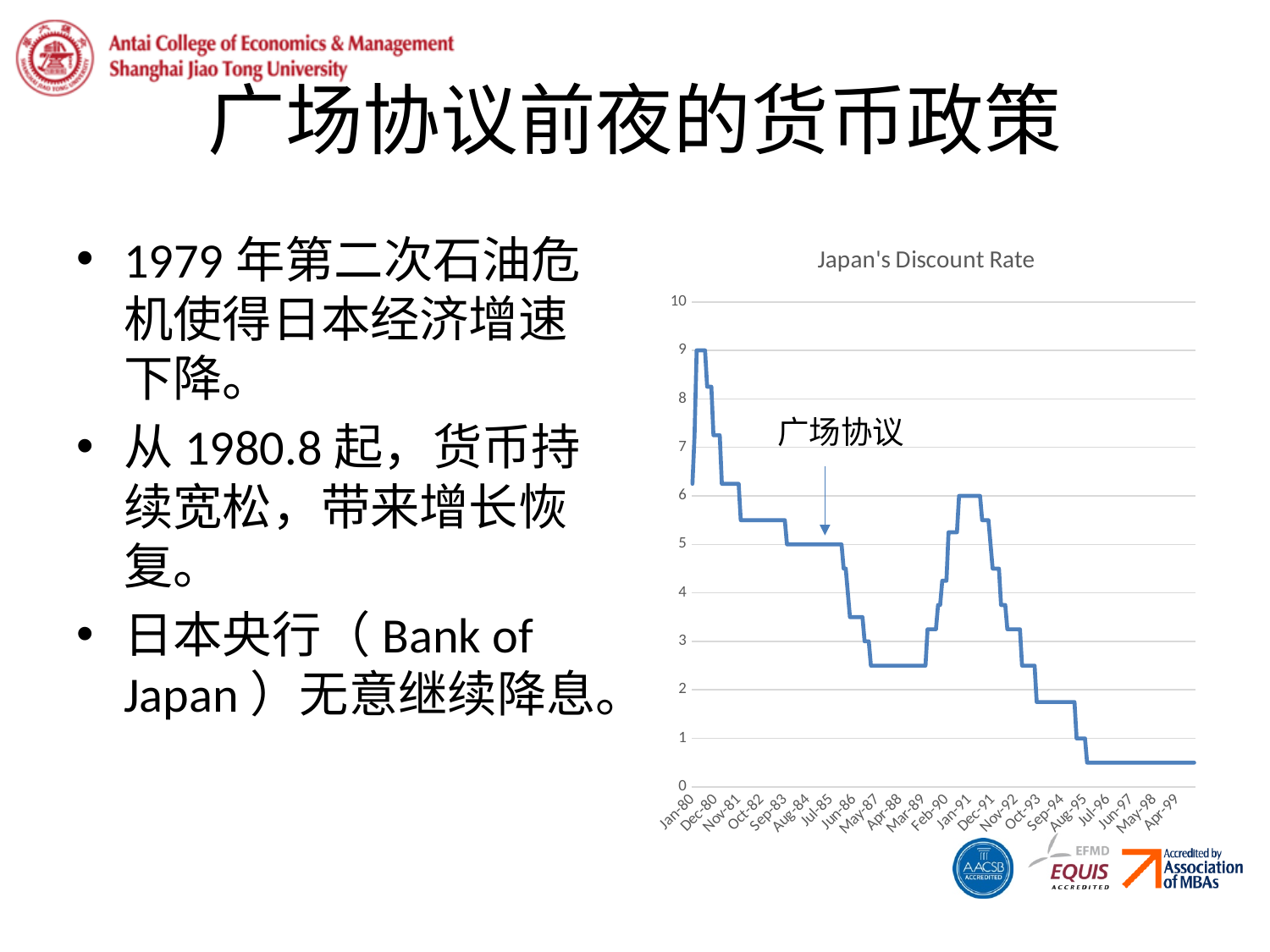
What is the highest value the line reaches in the Japan's Discount Rate chart? 9 What is the discount rate at the point marked by the 广场协议 arrow? 5 Which is larger, the value at Jan-91 or the value at Apr-99? Jan-91 Is the value at Jan-91 greater or less than 5? greater Is the value at Apr-99 greater or less than 1? less Is the value at Jan-80 greater or less than 5? greater What is the title of the chart? Japan's Discount Rate What kind of chart is shown on the slide? line chart What text is written in the annotation above the arrow on the chart? 广场协议 Overall, does the discount rate rise or fall from Jan-80 to Apr-99? fall